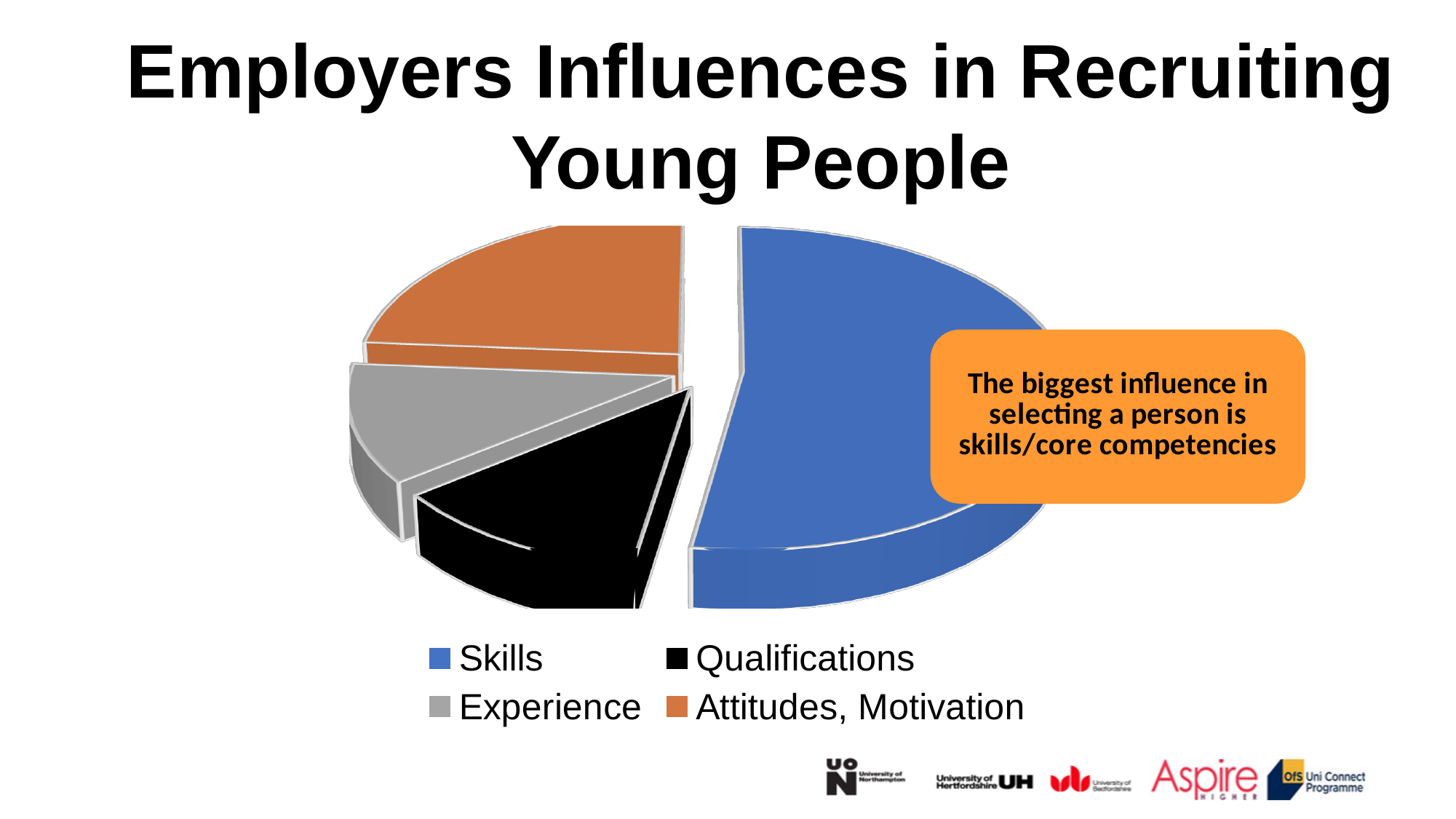
What colour is the Skills slice? Blue What kind of chart is shown on the slide? Pie chart Which is larger, the slice for Skills or the slice for Experience? Skills Which is larger, the slice for Skills or the slice for Attitudes, Motivation? Skills Which category is shown in orange in the legend? Attitudes, Motivation How many entries does the legend list? 4 How many slices does the pie chart have? 4 Which is larger, the slice for Skills or the slice for Qualifications? Skills Which category has the largest slice of the pie? Skills